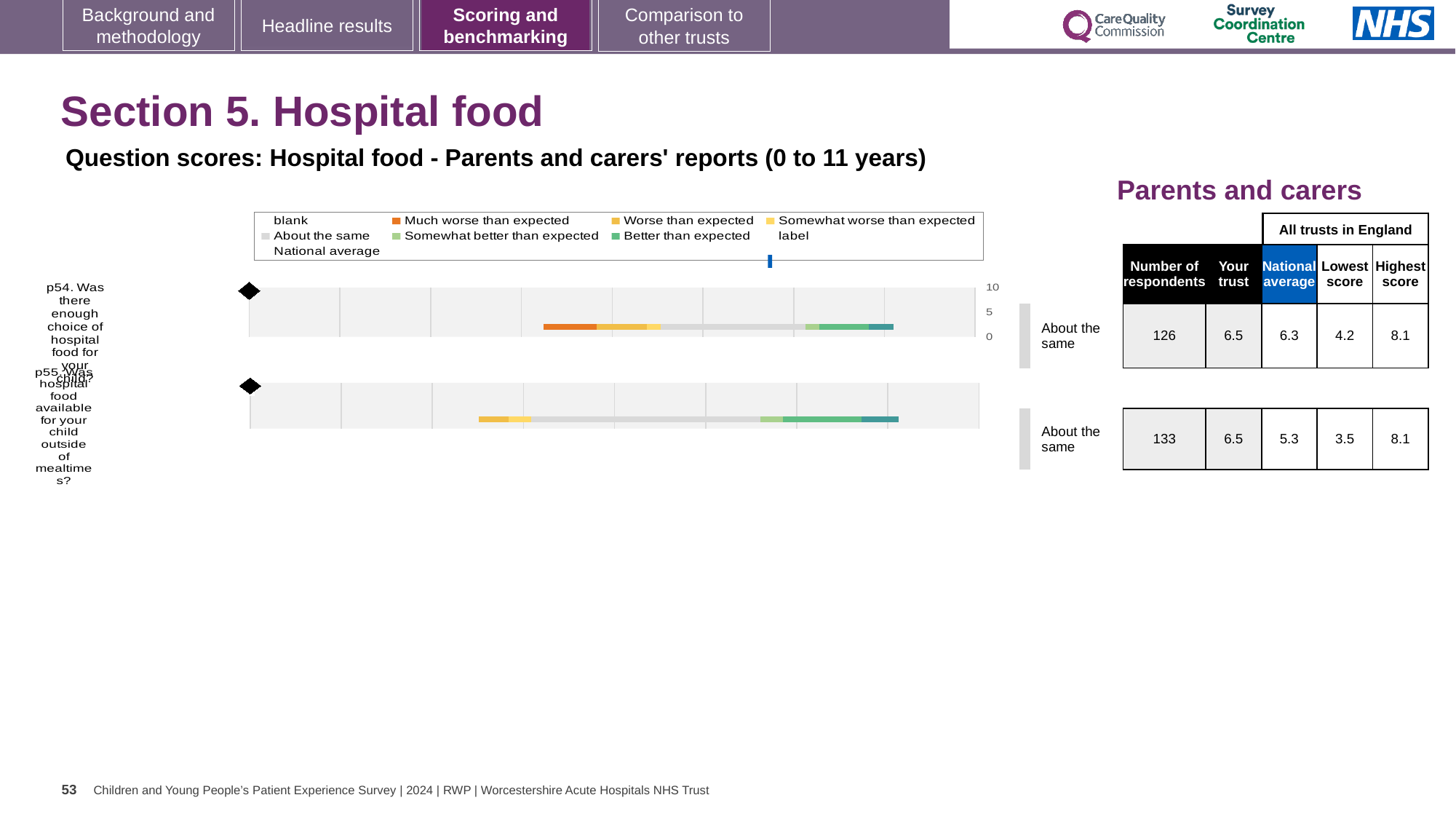
In the table beside the chart, which question has the lower national average, p54 or p55? p55 What colour does the legend use for 'Much worse than expected'? orange What is the highest value shown on the score axis of the hospital food chart? 10 What benchmark category is shown next to the bar for p54 (enough choice of hospital food)? About the same In the table beside the chart, how many respondents answered p55 (hospital food available outside of mealtimes)? 133 In the table beside the chart, what is the lowest score across all trusts in England for p55? 3.5 What kind of chart is used to show the question scores for hospital food? bar chart In the table beside the chart, what is the national average for p55 (hospital food available outside of mealtimes)? 5.3 What benchmark category is shown next to the bar for p55 (hospital food available outside of mealtimes)? About the same How many survey questions (categories) are plotted in the hospital food chart? 2 In the table beside the chart, what is the difference between the highest score and the lowest score for p54? 3.9 In the table beside the chart, what is the 'Your trust' score for p54 (enough choice of hospital food)? 6.5